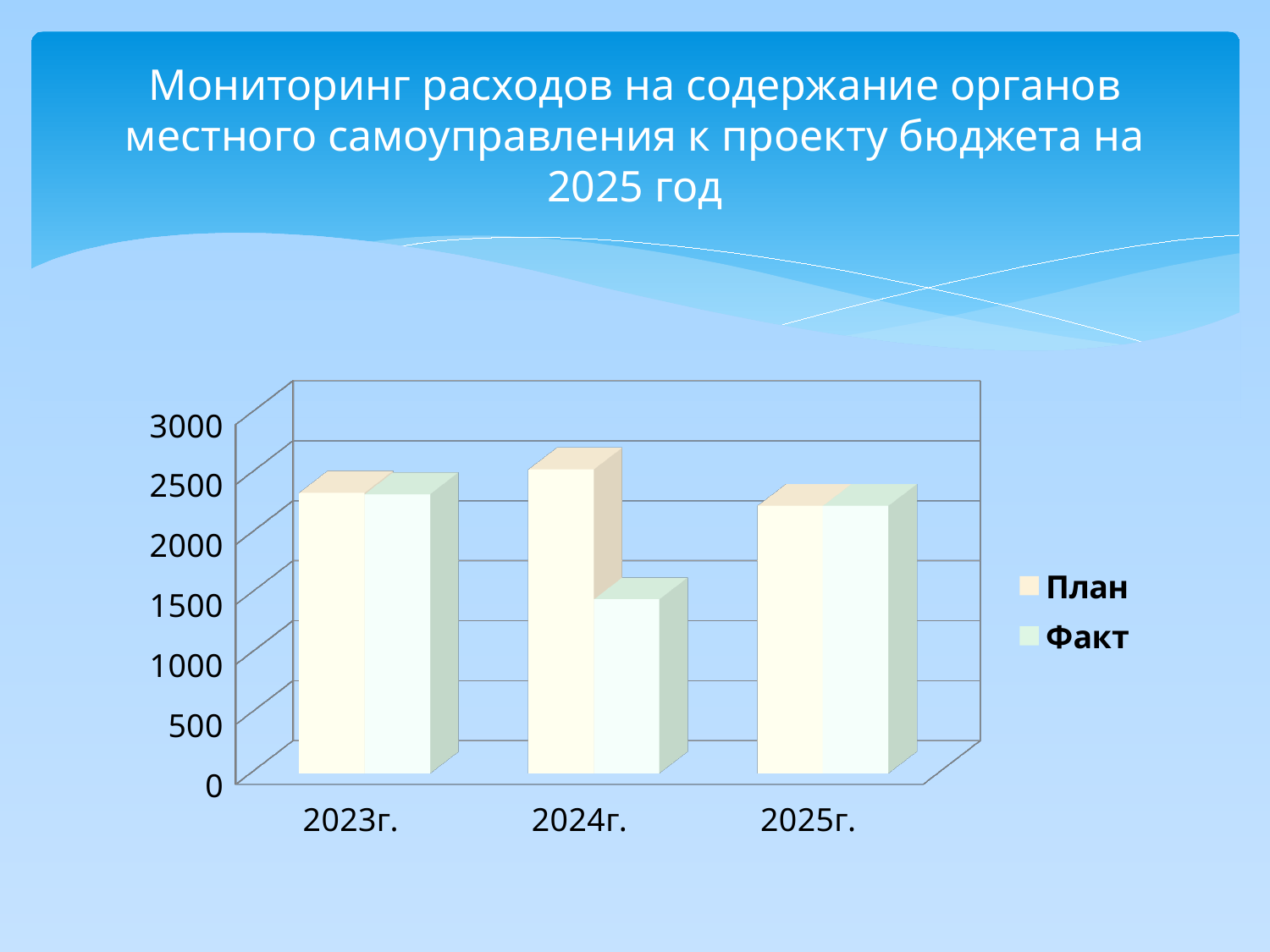
Which year has the highest План value? 2024г. Which year has the lowest Факт value? 2024г. What are the two series named in the legend? План and Факт For 2024г., which is larger, План or Факт? План How many years are shown on the x axis? 3 Is the Факт value for 2024г. greater or less than 2000? less Is the План value for 2024г. greater or less than 2000? greater What kind of chart is shown on the slide? bar chart What is the highest value shown on the vertical axis? 3000 Is the Факт value for 2024г. greater or less than 1000? greater How many series does the legend list? 2